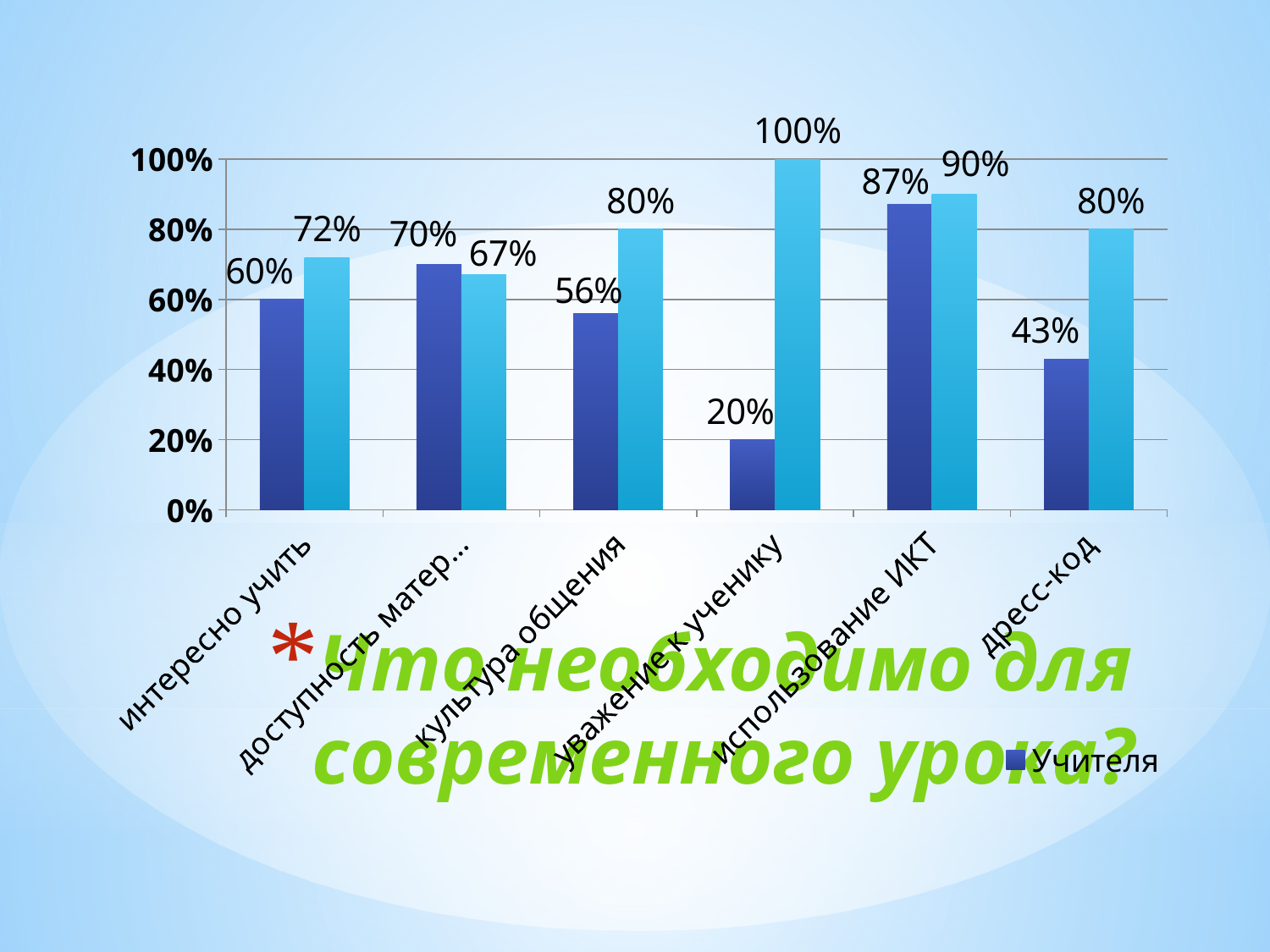
What is the value of the light blue bar in the category 'дресс-код'? 80% In which category does the Учителя series have its highest value? использование ИКТ What is the difference between the light blue bar and the Учителя bar in the category 'уважение к ученику'? 80% How many categories are shown on the x axis of the chart? 6 What is the value for Учителя in the category 'уважение к ученику'? 20% What is the value for Учителя in the category 'использование ИКТ'? 87% In which category does the light blue series reach its highest value? уважение к ученику What is the value of the light blue bar in the category 'интересно учить'? 72% In the category 'доступность матер...', which is larger: the Учителя bar or the light blue bar? Учителя What type of chart is shown on the slide? Bar chart In which category does the Учителя series have its lowest value? уважение к ученику What is the difference between the light blue bar and the Учителя bar in the category 'дресс-код'? 37%